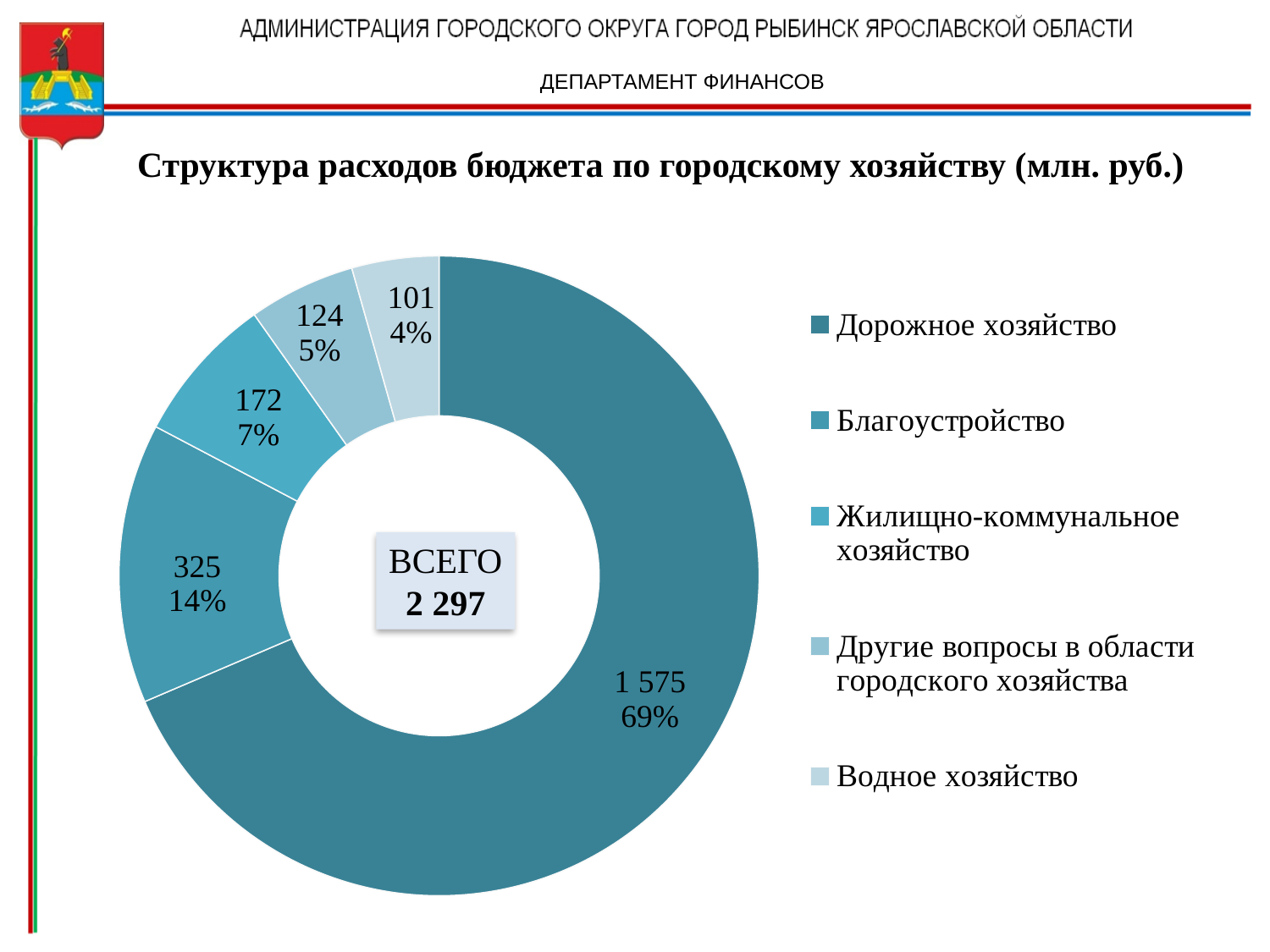
What is the value for Благоустройство? 325 What total (ВСЕГО) is shown in the centre of the chart? 2 297 Which category has the largest value? Дорожное хозяйство What is the value for Дорожное хозяйство? 1 575 What is the value for Водное хозяйство? 101 What kind of chart is shown on the slide? Doughnut (pie) chart Which category has the smallest value? Водное хозяйство What is the difference between the values for Благоустройство and Жилищно-коммунальное хозяйство? 153 What is the value for Жилищно-коммунальное хозяйство? 172 How many categories does the chart show? 5 What share of the total does Другие вопросы в области городского хозяйства represent? 5% What share of the total does Благоустройство represent? 14%